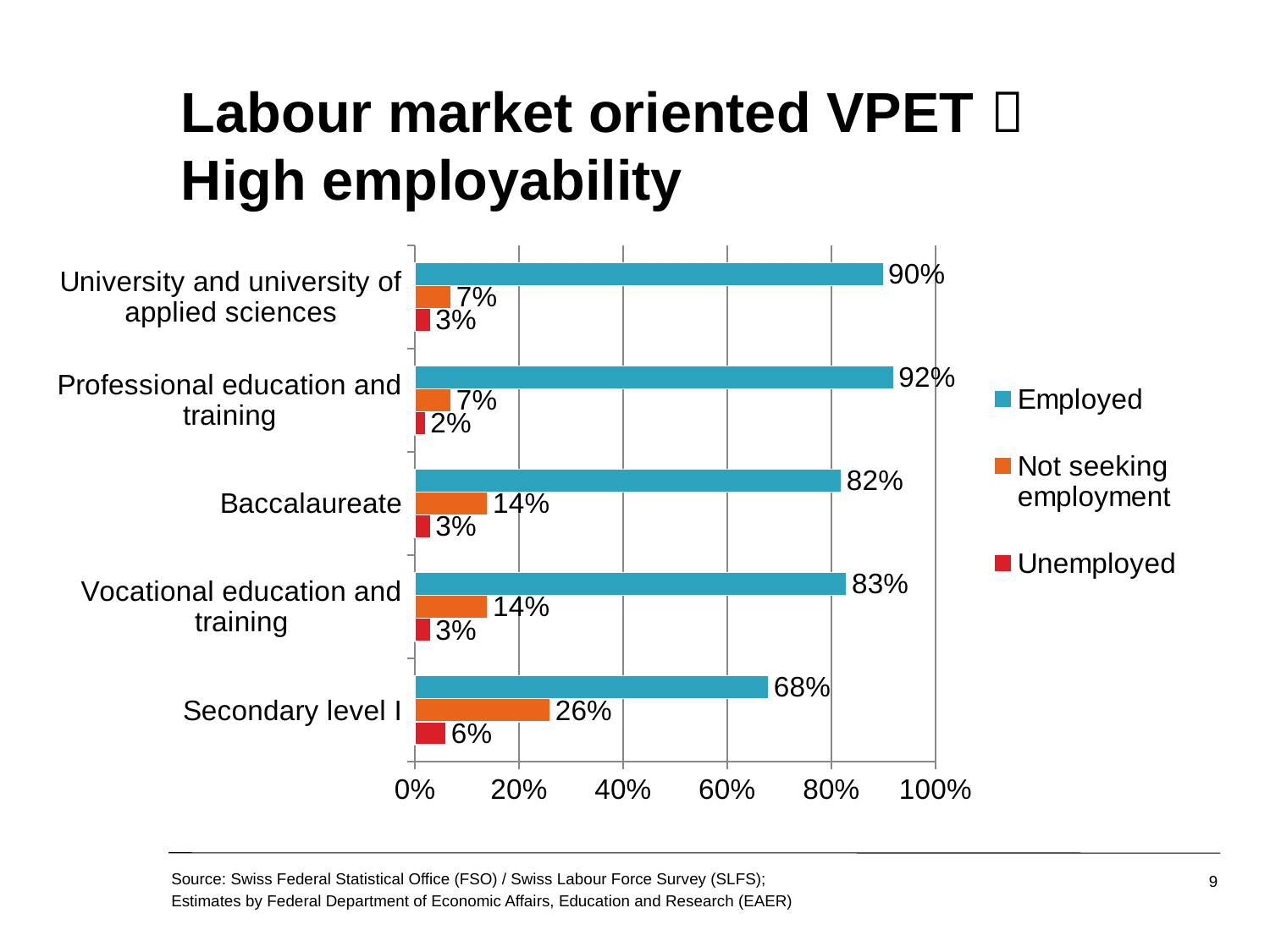
What is the Unemployed value for Baccalaureate? 3% What is the difference between the Employed values for Professional education and training and Secondary level I? 24% How many series does the legend list? 3 Which category has the highest Employed value? Professional education and training Which is larger, the Not seeking employment value for Baccalaureate or for University and university of applied sciences? Baccalaureate Which series is shown in red in the legend? Unemployed Is the Employed value for Vocational education and training greater or less than 80%? greater What is the Not seeking employment value for Secondary level I? 26% What is the Employed value for Professional education and training? 92% What kind of chart is shown on the slide? bar chart How many categories are shown on the chart? 5 Which category has the lowest Employed value? Secondary level I